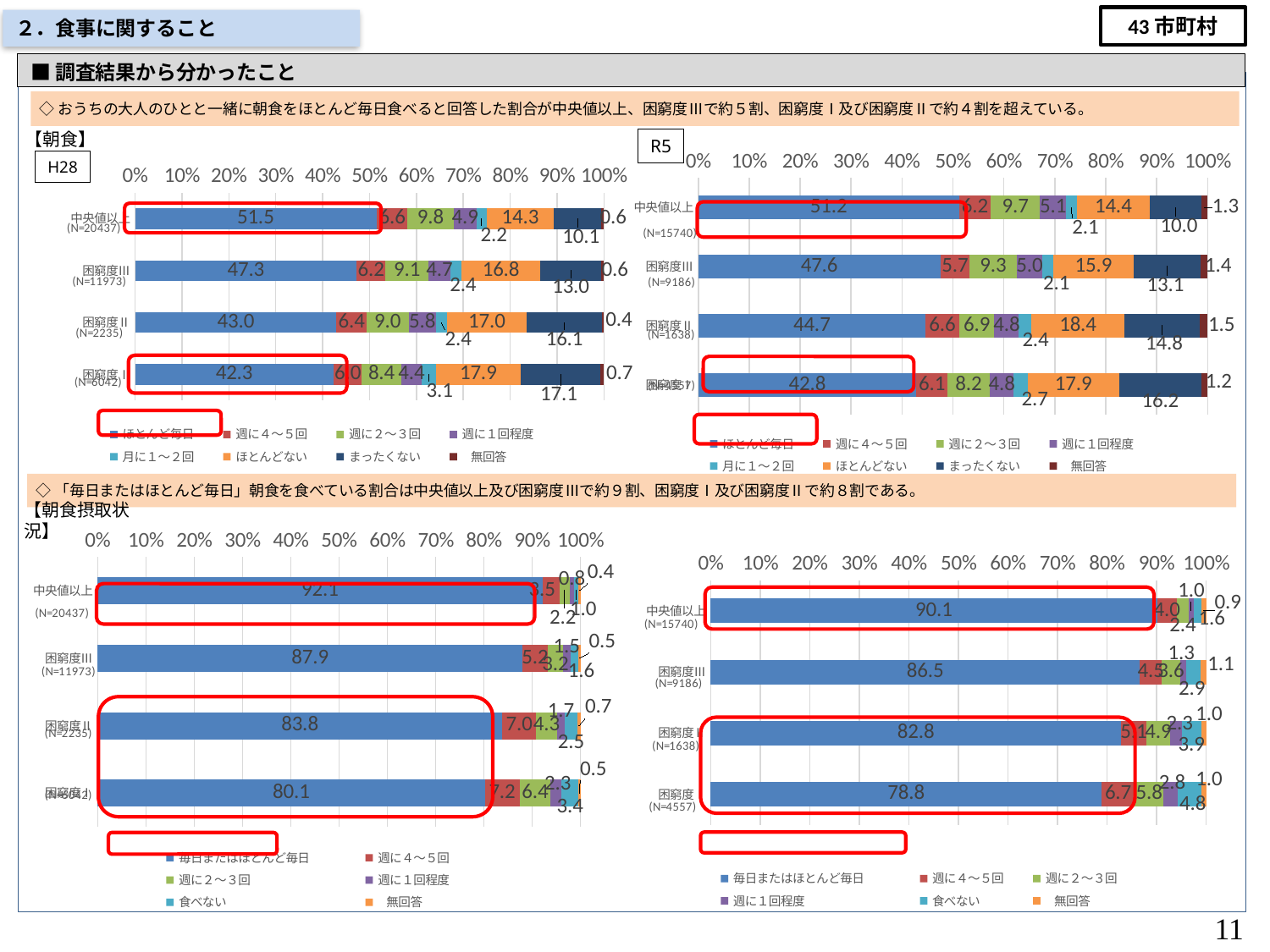
How many series does the legend of the bottom-right chart (R5 朝食摂取状況) list? 6 How many series does the legend of the top-left chart (H28 朝食) list? 8 How many categories are shown in the bottom-right chart (R5 朝食摂取状況)? 4 In the bottom-left chart (H28 朝食摂取状況), what is the difference between the 毎日またはほとんど毎日 values for 中央値以上 and 困窮度I? 12.0 In the bottom-right chart (R5 朝食摂取状況), which category has the lowest value for 毎日またはほとんど毎日? 困窮度I In the top-right chart (R5 朝食), what is the value of まったくない for 困窮度II? 14.8 In the top-right chart (R5 朝食), which is larger: the ほとんどない value for 困窮度II or for 困窮度I? 困窮度II In the top-right chart (R5 朝食), what is the value of ほとんど毎日 for 困窮度I? 42.8 In the top-left chart (H28 朝食), which category has the highest value for ほとんど毎日? 中央値以上 In the bottom-left chart (H28 朝食摂取状況), what is the value of 毎日またはほとんど毎日 for 困窮度III? 87.9 In the top-left chart (H28 朝食), what is the value of ほとんど毎日 for 中央値以上? 51.5 What kind of chart is the top-right chart (R5 朝食)? Stacked bar chart